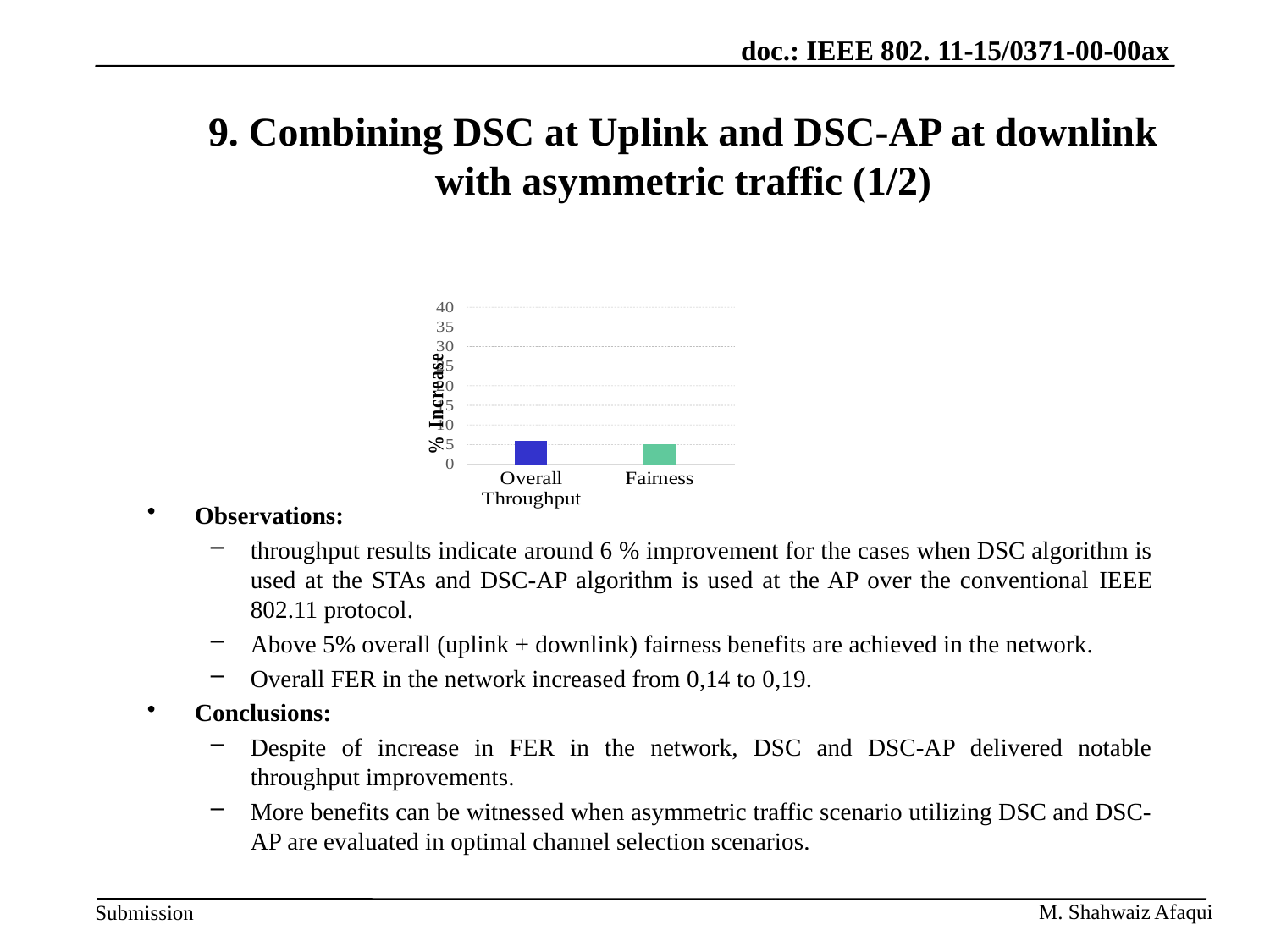
Which is larger, the value for Overall Throughput or the value for Fairness? Overall Throughput What is the label on the vertical axis of the chart? % Increase What kind of chart is shown on the slide? bar chart Which category has the lowest value on the chart? Fairness What is the highest tick value shown on the vertical axis? 40 How many categories are plotted on the chart? 2 Is the value for Overall Throughput greater or less than 10? less Which category has the highest value on the chart? Overall Throughput Do the values rise or fall from Overall Throughput to Fairness along the x axis? fall Is the value for Fairness greater or less than 10? less